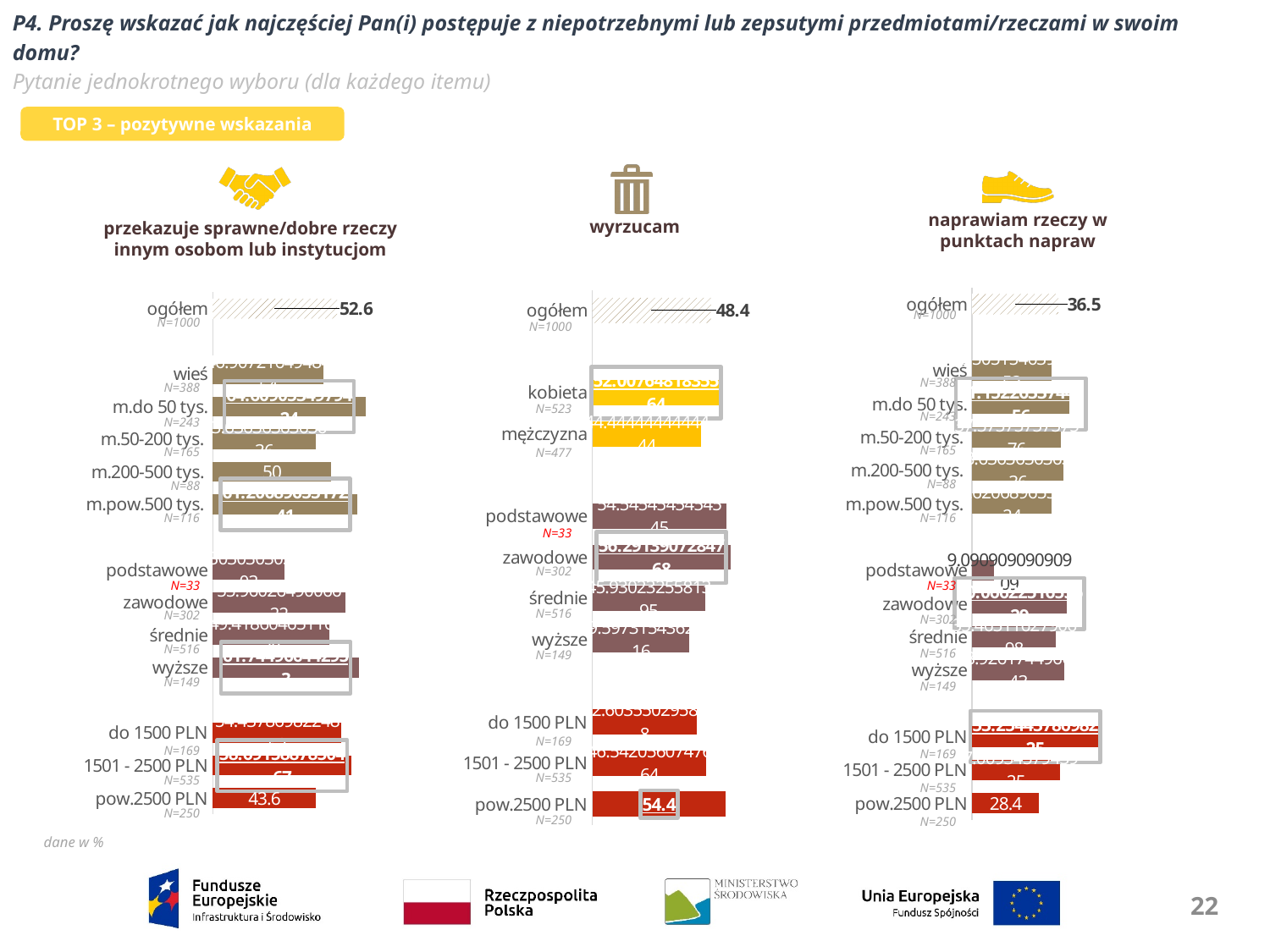
In the chart titled 'przekazuje sprawne/dobre rzeczy innym osobom lub instytucjom', what is the value for 'pow.2500 PLN'? 43.6 In the chart titled 'przekazuje sprawne/dobre rzeczy innym osobom lub instytucjom', what is the value for 'm.200-500 tys.'? 50 In the chart titled 'naprawiam rzeczy w punktach napraw', what is the value for 'pow.2500 PLN'? 28.4 What kind of chart is the chart titled 'wyrzucam'? bar chart In the chart titled 'wyrzucam', what is the difference between the value for 'pow.2500 PLN' and the value for 'ogółem'? 6 In the chart titled 'wyrzucam', what is the value for 'pow.2500 PLN'? 54.4 In the chart titled 'naprawiam rzeczy w punktach napraw', what is the difference between the value for 'ogółem' and the value for 'pow.2500 PLN'? 8.1 In the chart titled 'przekazuje sprawne/dobre rzeczy innym osobom lub instytucjom', what is the value for 'ogółem'? 52.6 In the chart titled 'wyrzucam', which is larger: the value for 'pow.2500 PLN' or the value for 'ogółem'? pow.2500 PLN How many charts are shown on the slide? 3 In the chart titled 'wyrzucam', what is the value for 'ogółem'? 48.4 In the chart titled 'naprawiam rzeczy w punktach napraw', what is the value for 'ogółem'? 36.5